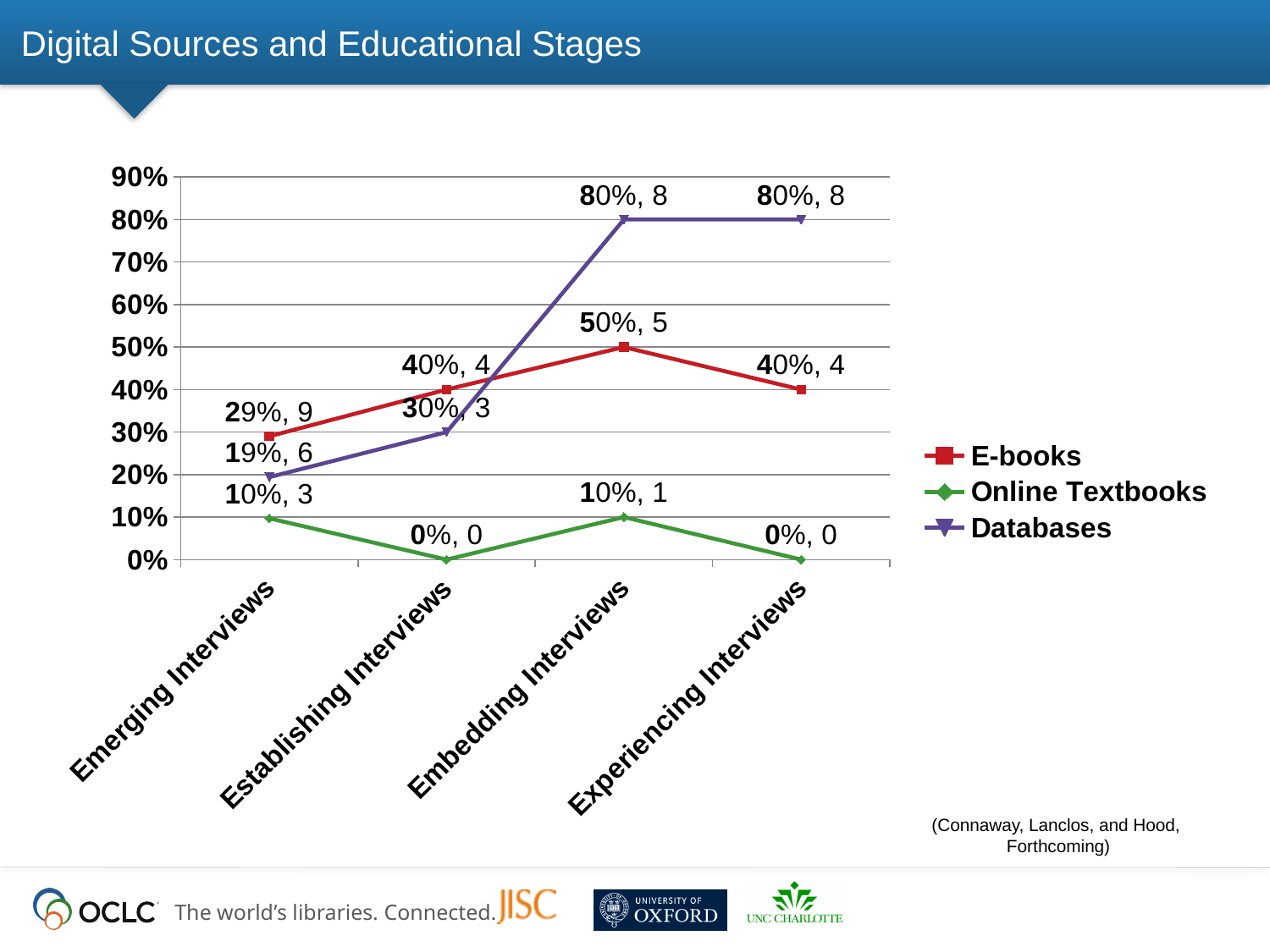
At which category does Databases have its lowest percentage? Emerging Interviews How many series does the legend list? 3 What percentage is shown for Databases at Establishing Interviews? 30% What percentage is shown for E-books at Emerging Interviews? 29% What is the difference in percentage between Databases and E-books at Experiencing Interviews? 40% What percentage is shown for Databases at Embedding Interviews? 80% What data label is shown for Online Textbooks at Emerging Interviews? 10%, 3 Which series is shown in green in the legend? Online Textbooks What type of chart is shown on the slide? line chart Which is larger at Emerging Interviews, the E-books percentage or the Databases percentage? E-books How many categories are shown on the x axis? 4 At which category does E-books reach its highest percentage? Embedding Interviews